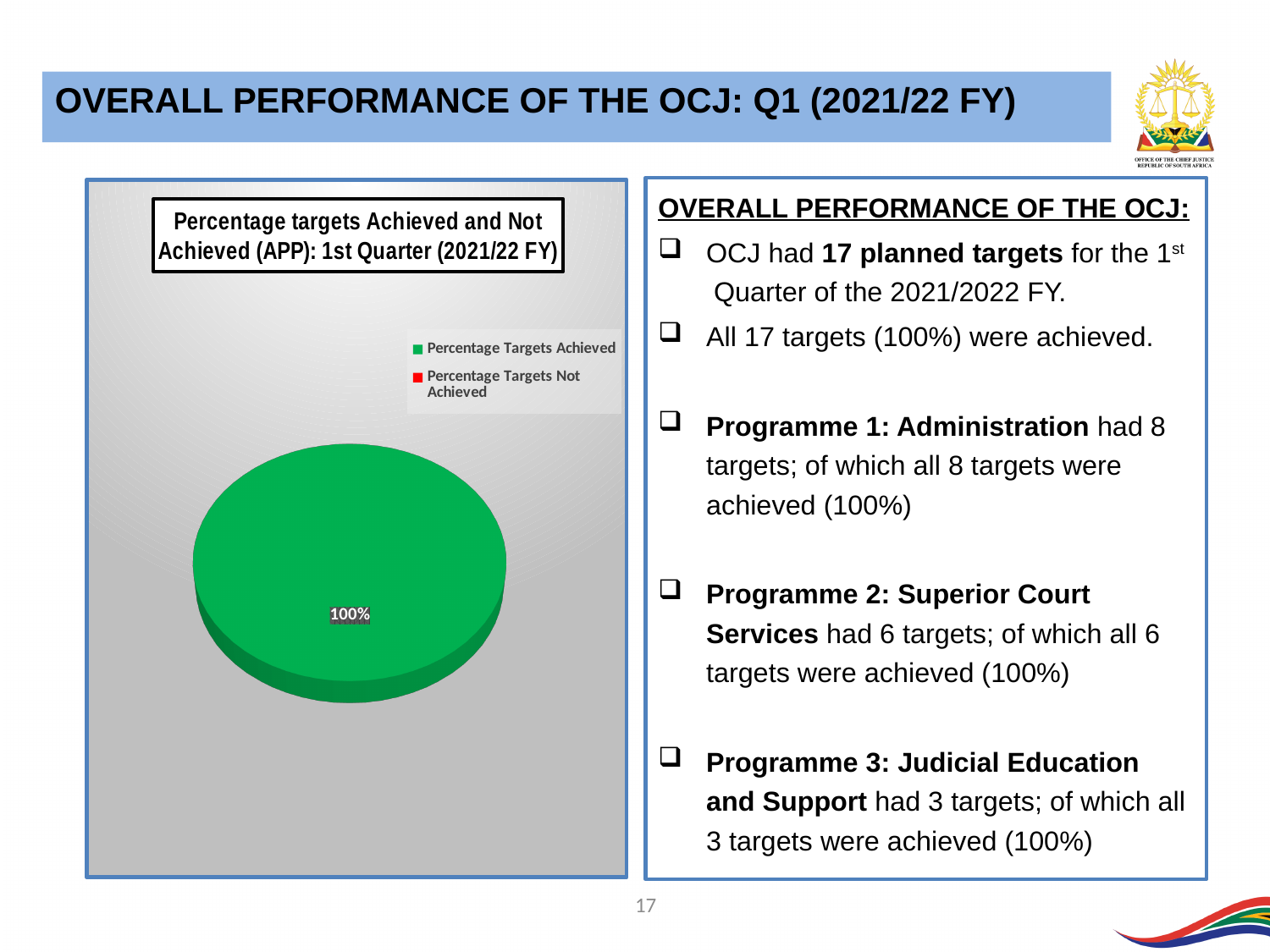
What value is labelled on the pie slice for Percentage Targets Achieved? 100% Is the value for Percentage Targets Achieved greater or less than 50%? greater How many data labels are printed on the pie chart? 1 Which category has the largest share of the pie? Percentage Targets Achieved What is the title of the chart? Percentage targets Achieved and Not Achieved (APP): 1st Quarter (2021/22 FY) How many entries does the chart's legend list? 2 Which legend entry corresponds to the green slice of the pie? Percentage Targets Achieved What kind of chart is shown on the slide? Pie chart What share of the pie does Percentage Targets Achieved take up? 100%